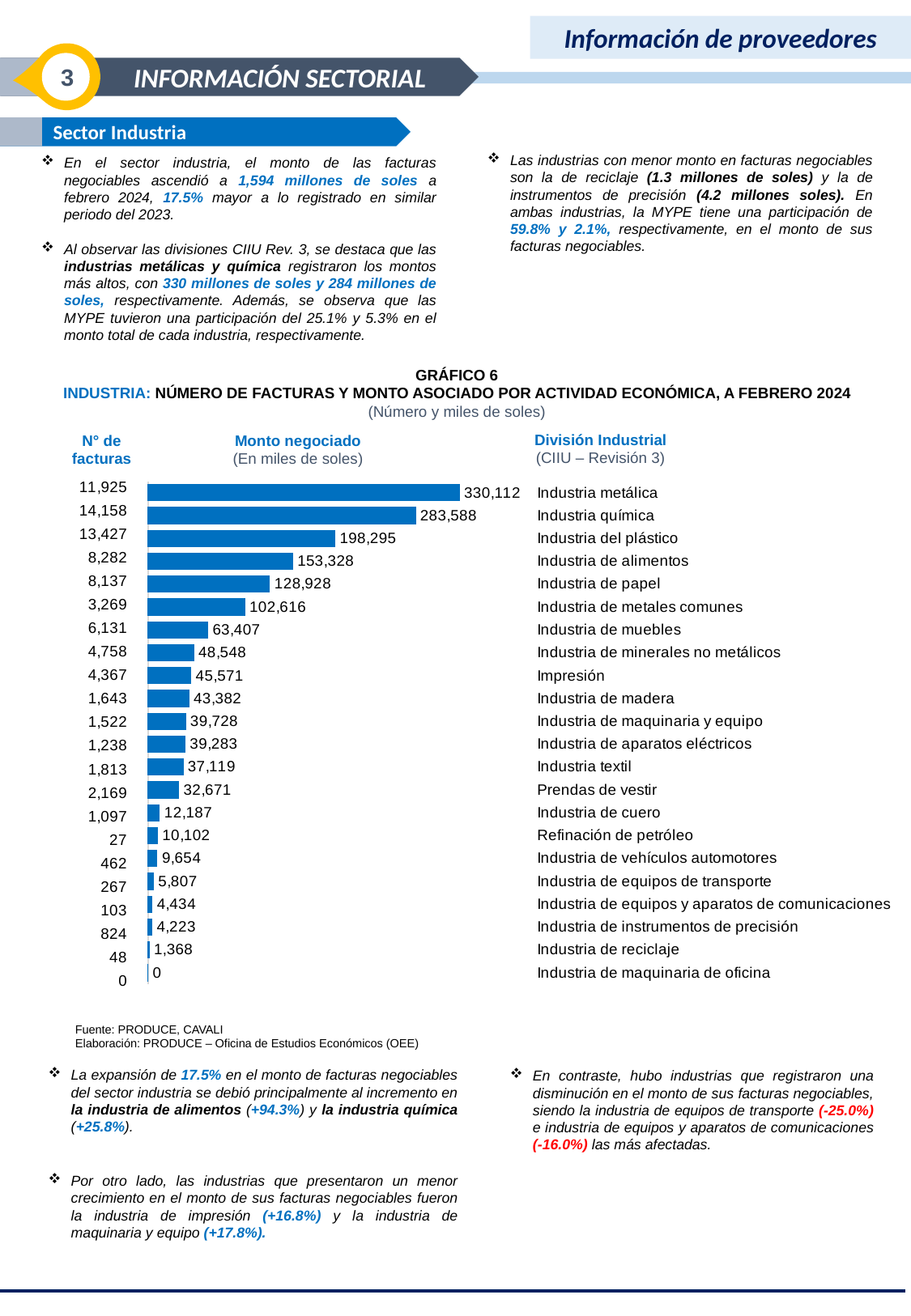
Which has a larger 'Monto negociado': Industria de muebles or Industria de madera? Industria de muebles What is the 'Monto negociado' value for Industria de papel? 128,928 What is the difference in 'Monto negociado' between Industria metálica and Industria química? 46,524 What kind of chart is Gráfico 6? Bar chart Which industrial division has the lowest 'Monto negociado'? Industria de maquinaria de oficina How many 'N° de facturas' are shown for Refinación de petróleo? 27 How many industrial divisions are listed in the chart? 22 Which industrial division has the highest 'Monto negociado'? Industria metálica What is the 'Monto negociado' value for Industria de reciclaje? 1,368 In what unit is the 'Monto negociado' expressed in the chart? Miles de soles What is the 'Monto negociado' value for Industria química? 283,588 What is the difference in 'Monto negociado' between Industria de alimentos and Industria de papel? 24,400